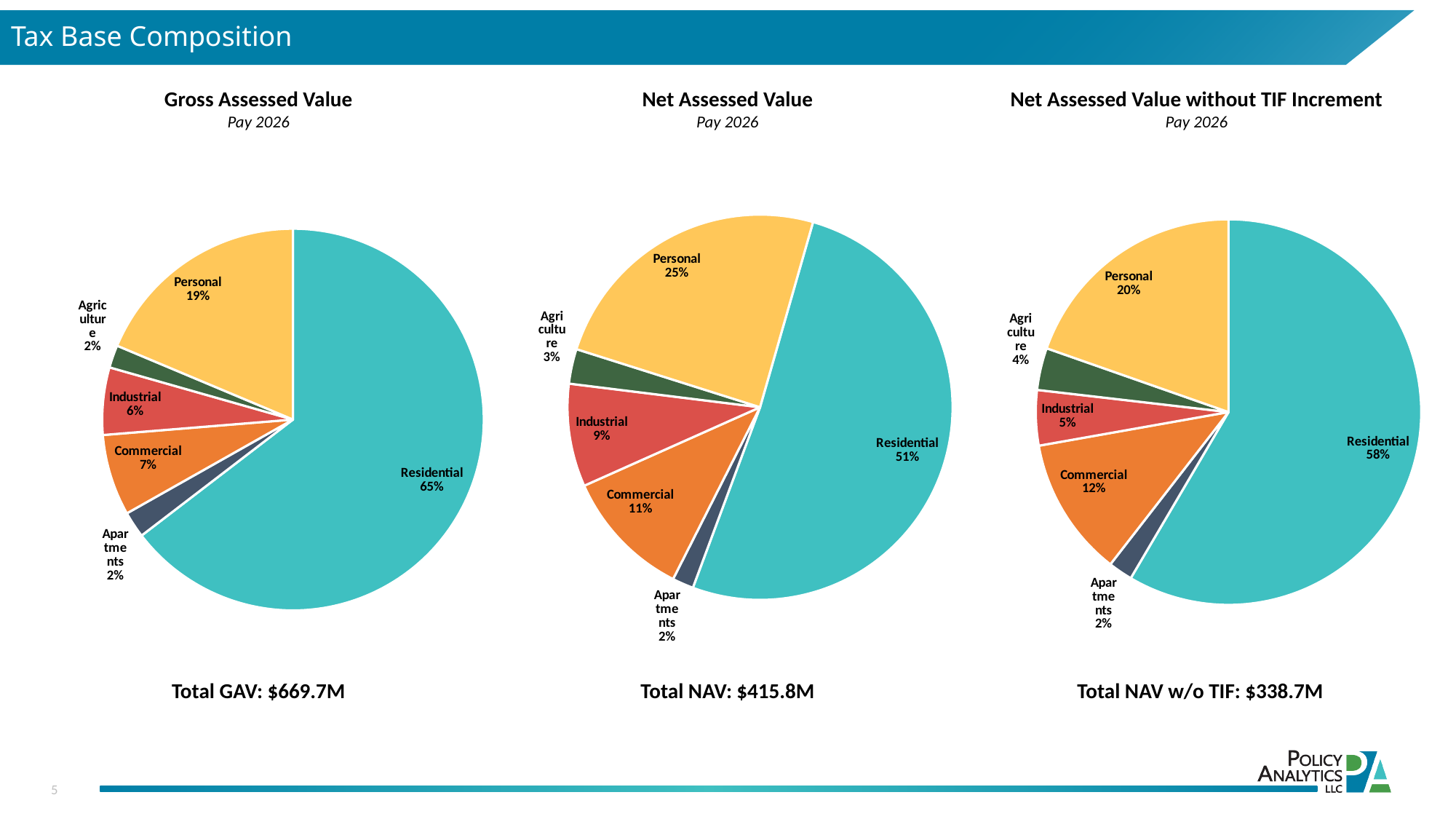
In the Gross Assessed Value pie chart, which category has the largest slice? Residential In the Gross Assessed Value pie chart, what share does Industrial hold? 6% How many categories are shown in the Gross Assessed Value pie chart? 6 What total is printed below the Net Assessed Value without TIF Increment chart? Total NAV w/o TIF: $338.7M In the Net Assessed Value pie chart, which category has the smallest slice? Apartments In the Net Assessed Value pie chart, what share does Personal hold? 25% What pay year is shown in the subtitle of the Gross Assessed Value chart? Pay 2026 In the Gross Assessed Value pie chart, what share does Residential hold? 65% In the Net Assessed Value without TIF Increment pie chart, which is larger, Industrial or Commercial? Commercial What kind of chart is used for Net Assessed Value? Pie chart In the Net Assessed Value pie chart, what is the difference between the Residential share and the Personal share? 26%